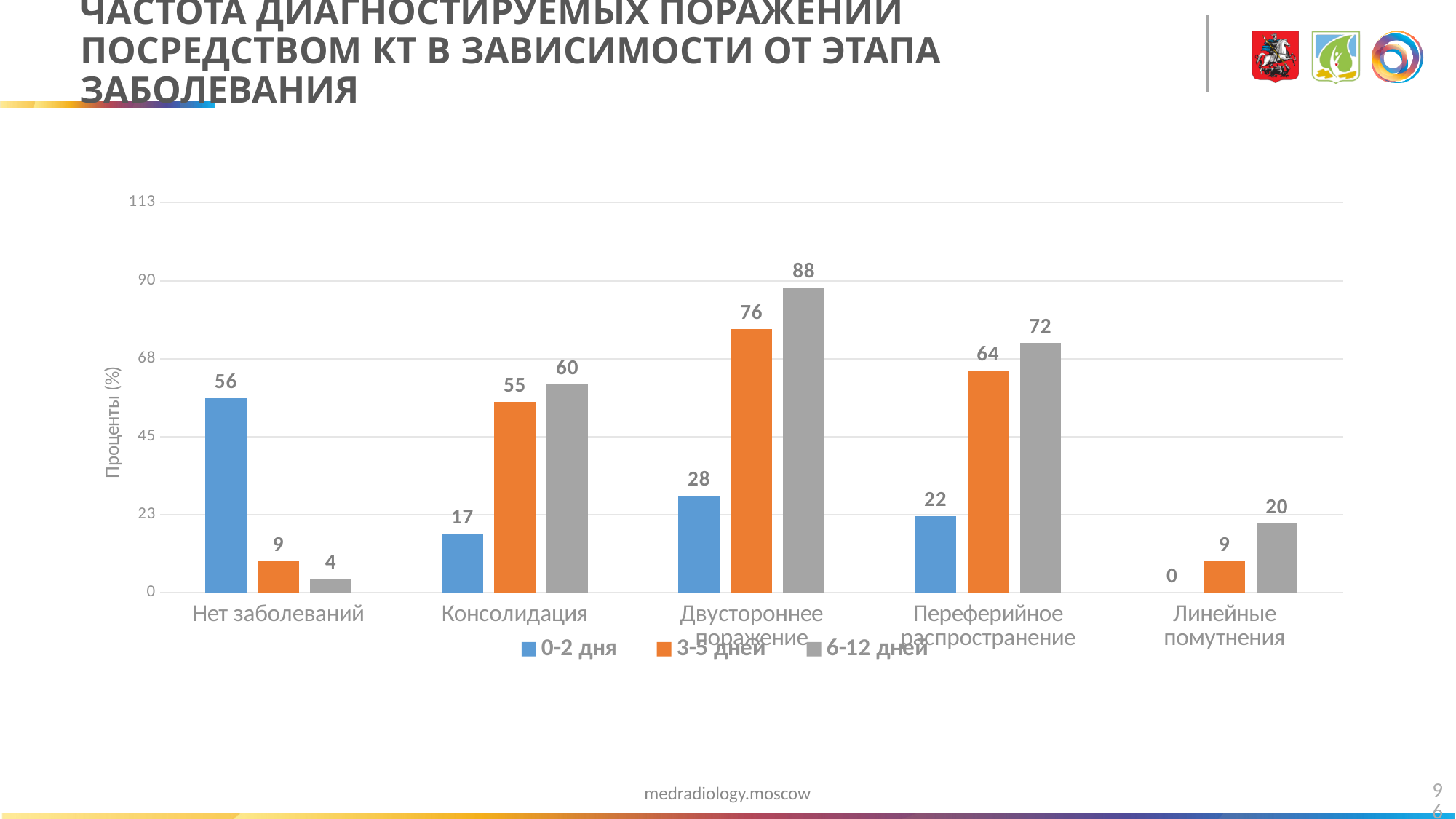
What is the label of the y axis? Проценты (%) What is the value for '0-2 дня' in the 'Нет заболеваний' category? 56 What is the difference between the '6-12 дней' and '0-2 дня' values in the 'Консолидация' category? 43 Which category has the highest value for the '6-12 дней' series? Двустороннее поражение What kind of chart is shown on the slide? Bar chart Which is larger in the 'Переферийное распространение' category: the '3-5 дней' value or the '6-12 дней' value? 6-12 дней What is the value for '6-12 дней' in the 'Двустороннее поражение' category? 88 How many categories are shown on the x axis? 5 How many series does the legend list? 3 What is the value for '3-5 дней' in the 'Переферийное распространение' category? 64 What is the value for '0-2 дня' in the 'Линейные помутнения' category? 0